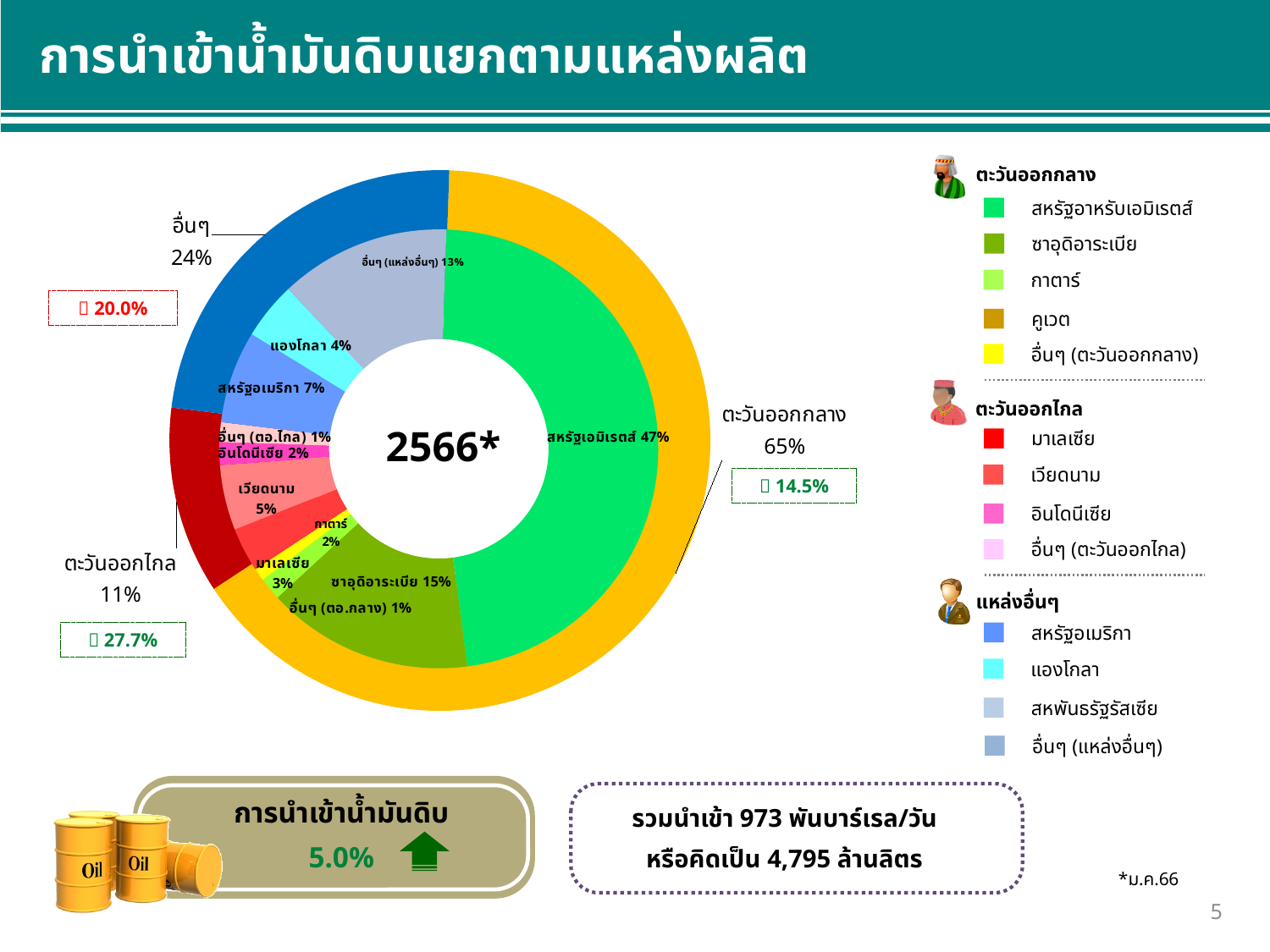
What share does ซาอุดิอาระเบีย hold in the inner ring of the doughnut chart? 15% What percentage is shown for ตะวันออกไกล in the outer ring of the doughnut chart? 11% What type of chart is shown on the slide? doughnut chart Which region has the smallest share in the outer ring of the doughnut chart? ตะวันออกไกล What percentage is shown for อื่นๆ in the outer ring of the doughnut chart? 24% Which has a larger share in the inner ring: เวียดนาม or สหรัฐอเมริกา? สหรัฐอเมริกา Which region has the largest share in the outer ring of the doughnut chart? ตะวันออกกลาง What year label is printed in the centre of the doughnut chart? 2566* What share of crude oil imports comes from สหรัฐเอมิเรตส์ in the inner ring of the doughnut chart? 47% What percentage is shown for ตะวันออกกลาง in the outer ring of the doughnut chart? 65% What is the difference in percentage points between ตะวันออกกลาง (65%) and อื่นๆ (24%) in the outer ring? 41 Which source has the largest share in the inner ring of the doughnut chart? สหรัฐเอมิเรตส์